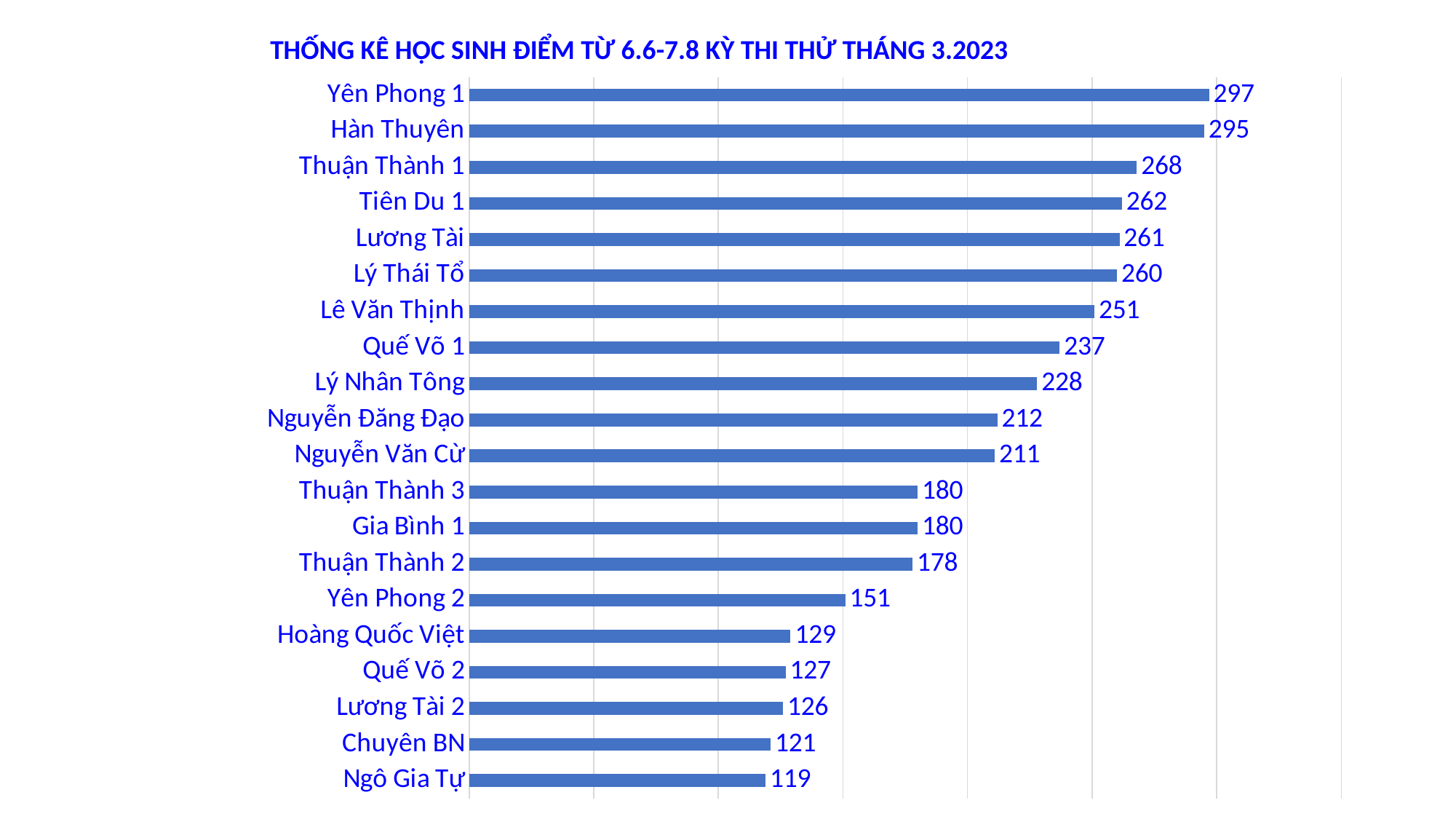
Which has a larger value, Lý Nhân Tông or Nguyễn Đăng Đạo? Lý Nhân Tông Which school has the highest value? Yên Phong 1 Which has a larger value, Hoàng Quốc Việt or Yên Phong 2? Yên Phong 2 What type of chart is shown on the slide? Bar chart What is the difference between the values for Quế Võ 1 and Quế Võ 2? 110 What is the difference between the values for Yên Phong 1 and Hàn Thuyên? 2 What is the title of the chart? THỐNG KÊ HỌC SINH ĐIỂM TỪ 6.6-7.8 KỲ THI THỬ THÁNG 3.2023 How many schools are shown in the chart? 20 What is the value for Lê Văn Thịnh? 251 What is the value for Chuyên BN? 121 What is the value for Yên Phong 1? 297 Which school has the lowest value? Ngô Gia Tự